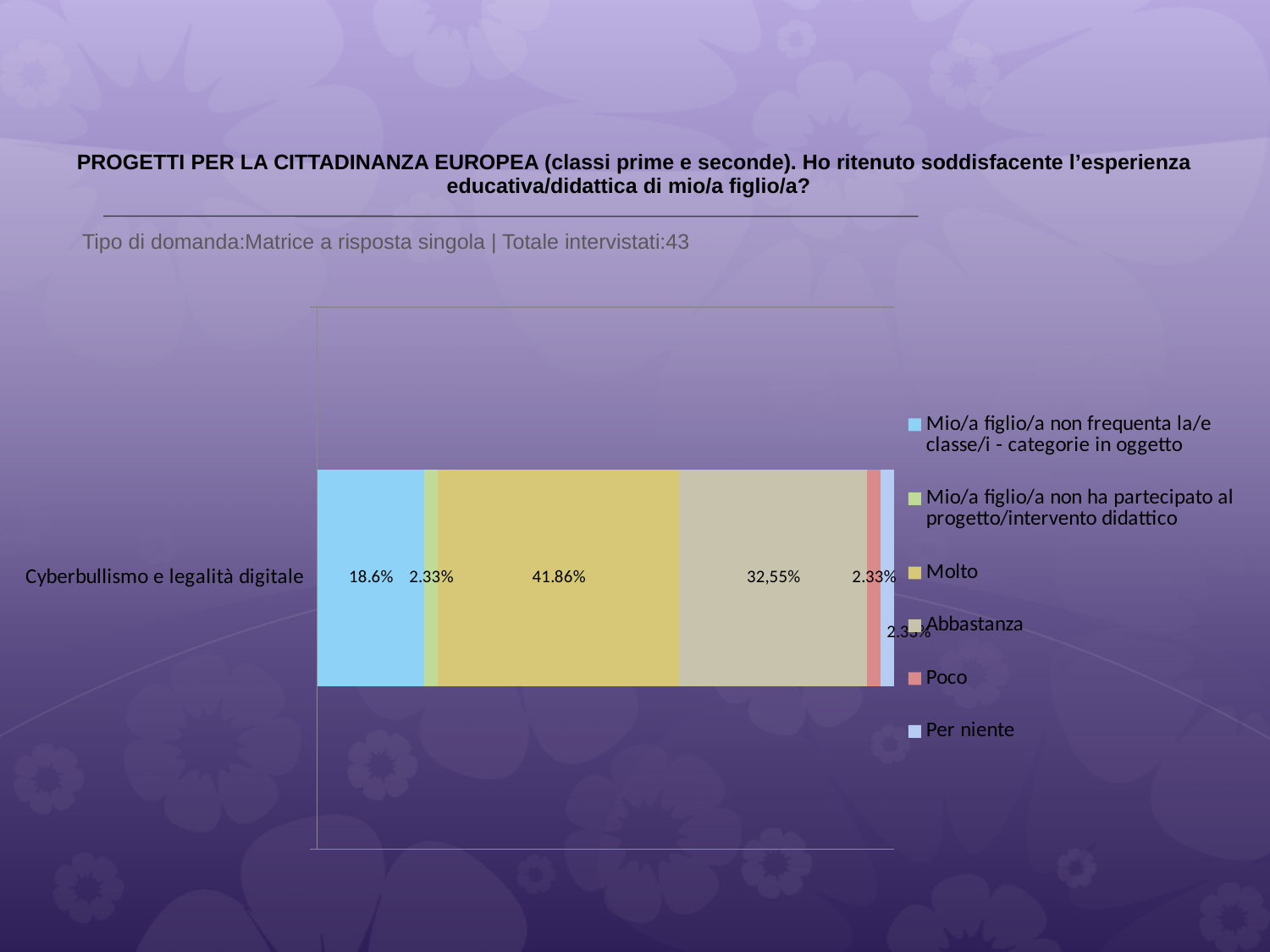
What kind of chart is shown on the slide? Stacked bar chart Which series has the largest share of the bar? Molto What is the value for "Abbastanza" in the Cyberbullismo e legalità digitale bar? 32,55% What is the difference between the values for "Molto" and "Abbastanza"? 9.31 percentage points What is the value for "Poco"? 2.33% How many series does the legend list? 6 According to the subtitle, how many respondents were surveyed (Totale intervistati)? 43 What is the value for "Mio/a figlio/a non ha partecipato al progetto/intervento didattico"? 2.33% Which is larger, the value for "Molto" or the value for "Abbastanza"? Molto What is the value for "Mio/a figlio/a non frequenta la/e classe/i - categorie in oggetto"? 18.6% How many categories are plotted on the chart? 1 What is the value for "Molto" in the Cyberbullismo e legalità digitale bar? 41.86%